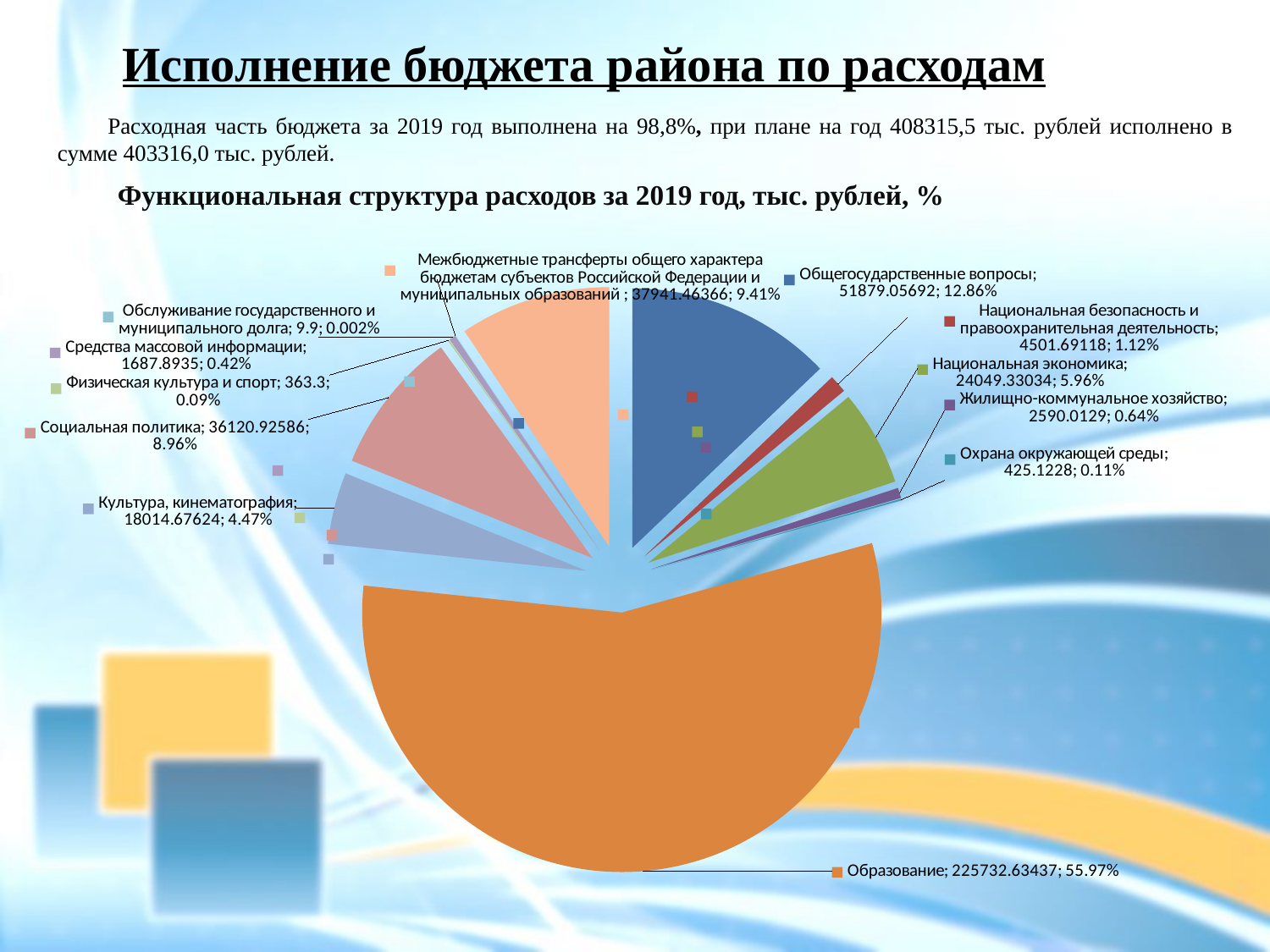
How many categories (slices) does the pie chart show? 12 What is the value shown for Социальная политика? 36120.92586 Which category has the largest slice in the pie chart? Образование What kind of chart is shown on the slide? pie chart What is the difference in percentage points between the shares of Общегосударственные вопросы (12.86%) and Социальная политика (8.96%)? 3.9 What percentage is shown for Охрана окружающей среды? 0.11% What share of the pie does Образование account for? 55.97% What percentage is shown for Общегосударственные вопросы? 12.86% Which is larger: the share for Национальная экономика or the share for Культура, кинематография? Национальная экономика What is the title of the pie chart? Функциональная структура расходов за 2019 год, тыс. рублей, % What is the value shown for Образование in the pie chart? 225732.63437 Which category has the smallest slice in the pie chart? Обслуживание государственного и муниципального долга